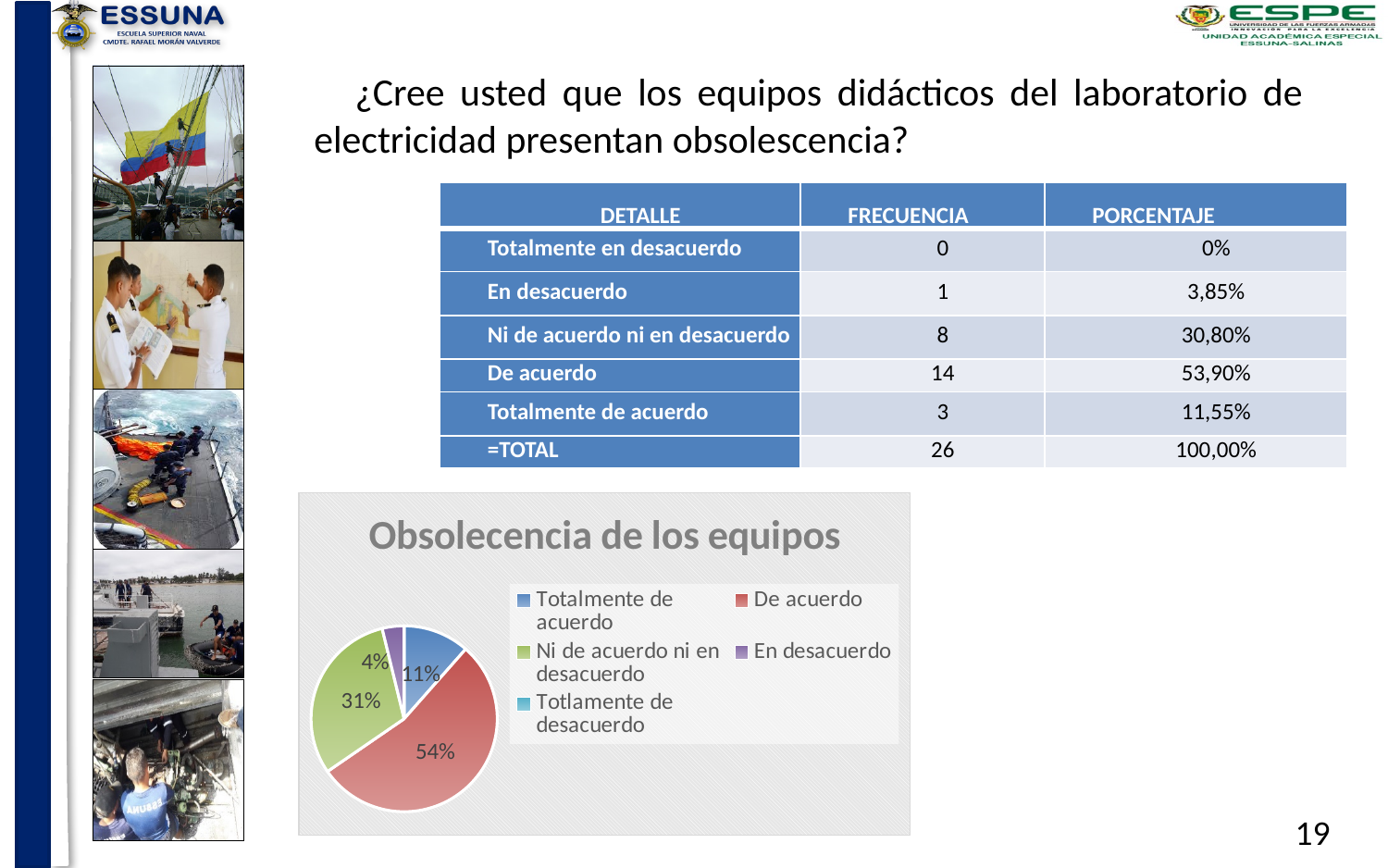
In the pie chart, what share is shown for "Totalmente de acuerdo"? 11% What is the title of the pie chart? Obsolecencia de los equipos What kind of chart is shown under the title "Obsolecencia de los equipos"? pie chart Which category has the largest slice in the pie chart? De acuerdo In the pie chart, what share is shown for "En desacuerdo"? 4% In the pie chart, which is larger: the slice for "Ni de acuerdo ni en desacuerdo" or the slice for "Totalmente de acuerdo"? Ni de acuerdo ni en desacuerdo How many entries does the legend of the pie chart list? 5 In the pie chart, what share is shown for "De acuerdo"? 54% Which labelled slice in the pie chart is the smallest? En desacuerdo What colour is the "De acuerdo" slice in the pie chart? red What is the difference in percentage points between the "De acuerdo" slice and the "Ni de acuerdo ni en desacuerdo" slice in the pie chart? 23%